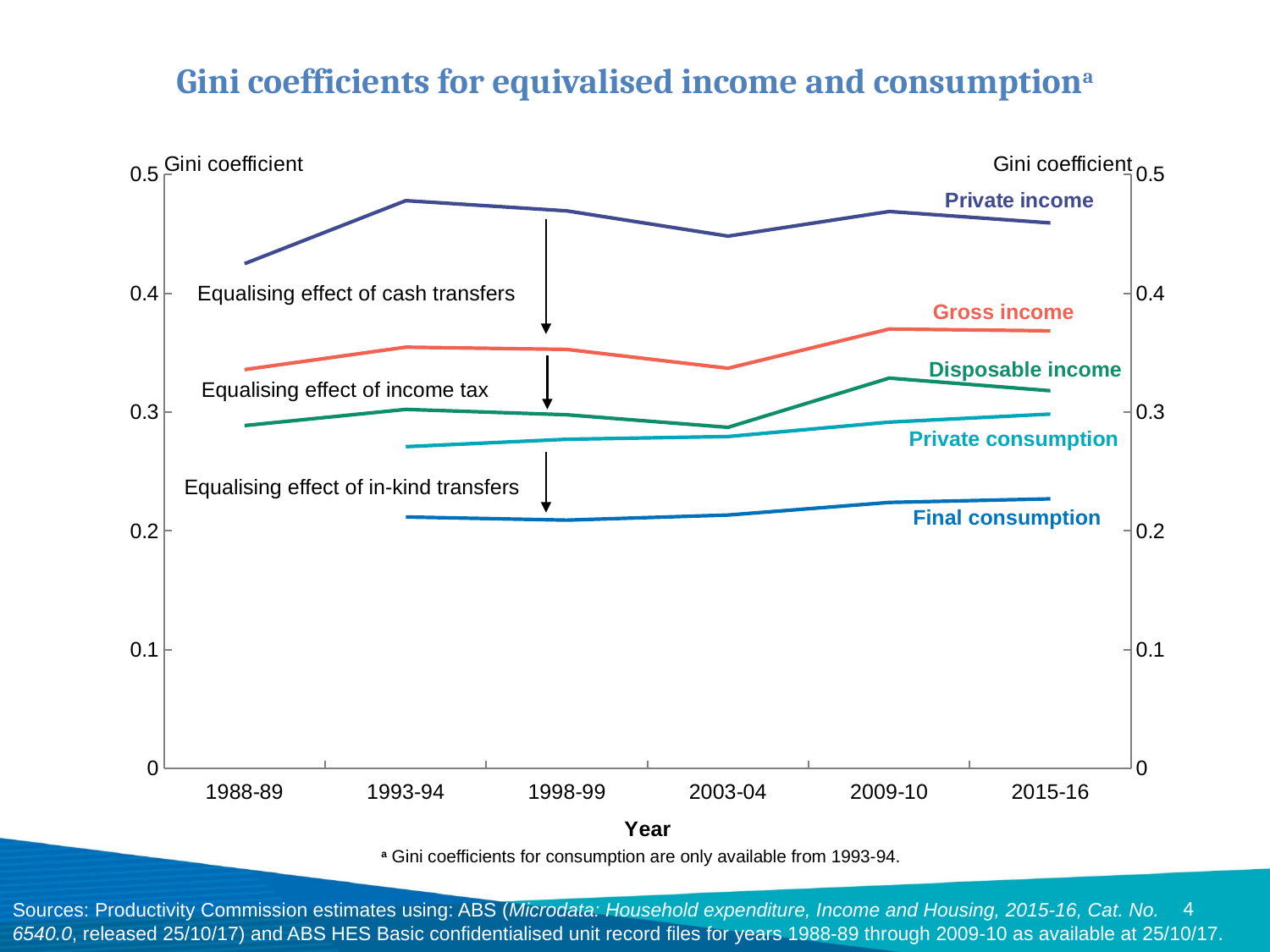
How many years are marked on the x axis of the chart? 6 Is the value for Private income in 1993-94 greater or less than 0.4? greater Which series has the highest Gini coefficient in 2015-16? Private income Is the value for Private consumption in 1993-94 greater or less than 0.3? less In 2009-10, which is larger: Disposable income or Private consumption? Disposable income What kind of chart is shown on the slide? Line chart Which series has the lowest Gini coefficient in 2015-16? Final consumption How many series are plotted on the chart? 5 Is the value for Final consumption in 2015-16 greater or less than 0.2? greater Does the Final consumption series rise or fall from 1998-99 to 2015-16? Rise What is the label of the x axis of the chart? Year